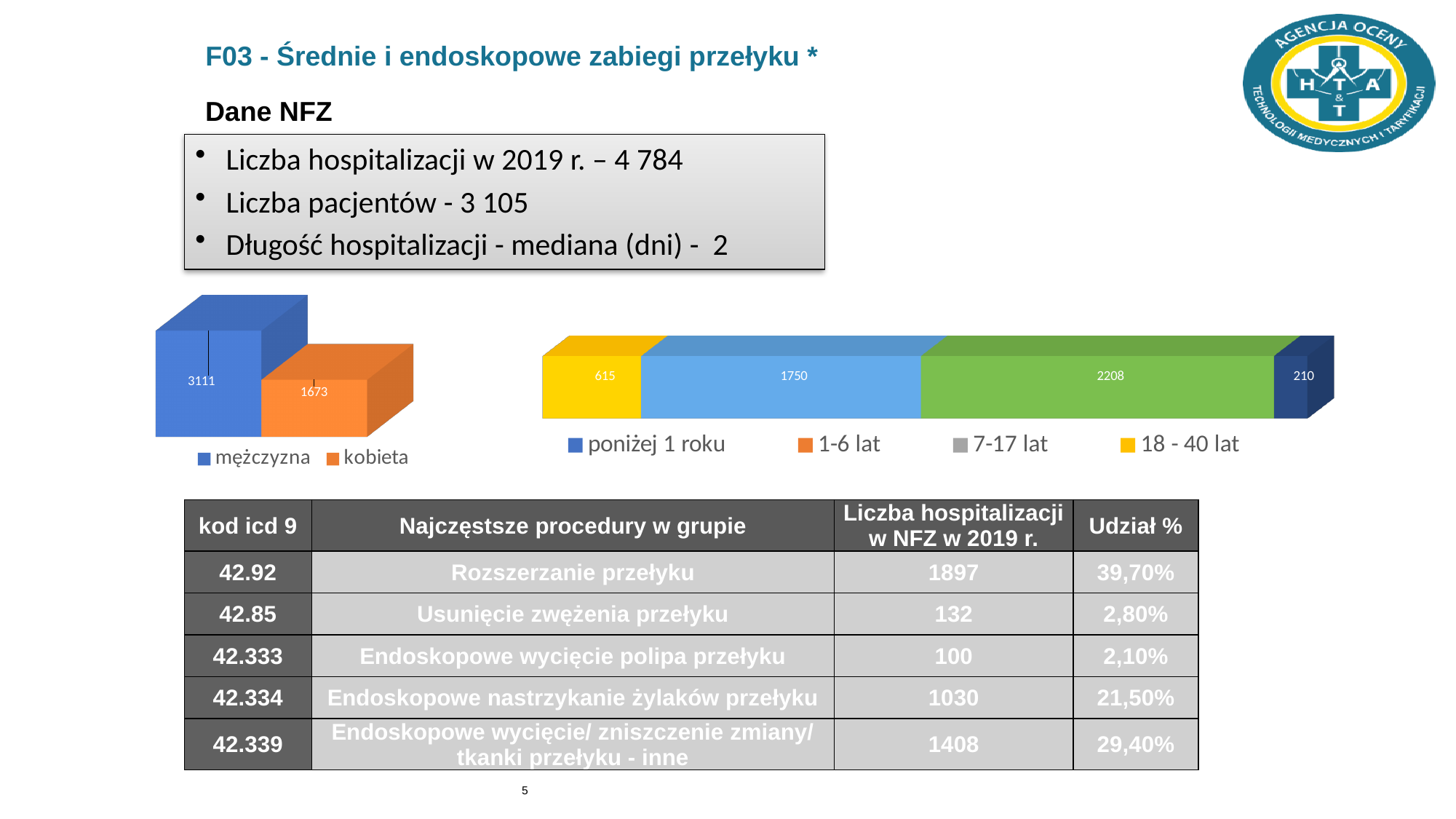
In the left chart, what is the value for mężczyzna? 3111 In the left chart, which category has the higher value, mężczyzna or kobieta? mężczyzna In the right chart, what is the value of the rightmost (dark blue) segment? 210 In the right chart, what is the value of the leftmost (yellow) segment? 615 In the right chart, how many entries does the legend list? 4 What kind of chart is the left chart? bar chart In the left chart, how many series does the legend list? 2 In the left chart, what is the value for kobieta? 1673 In the left chart, what is the difference between the values for mężczyzna and kobieta? 1438 In the right chart, what is the value of the green segment? 2208 In the right chart, what is the total of all segments in the stacked bar? 4783 In the right chart, how many segments make up the stacked bar? 4